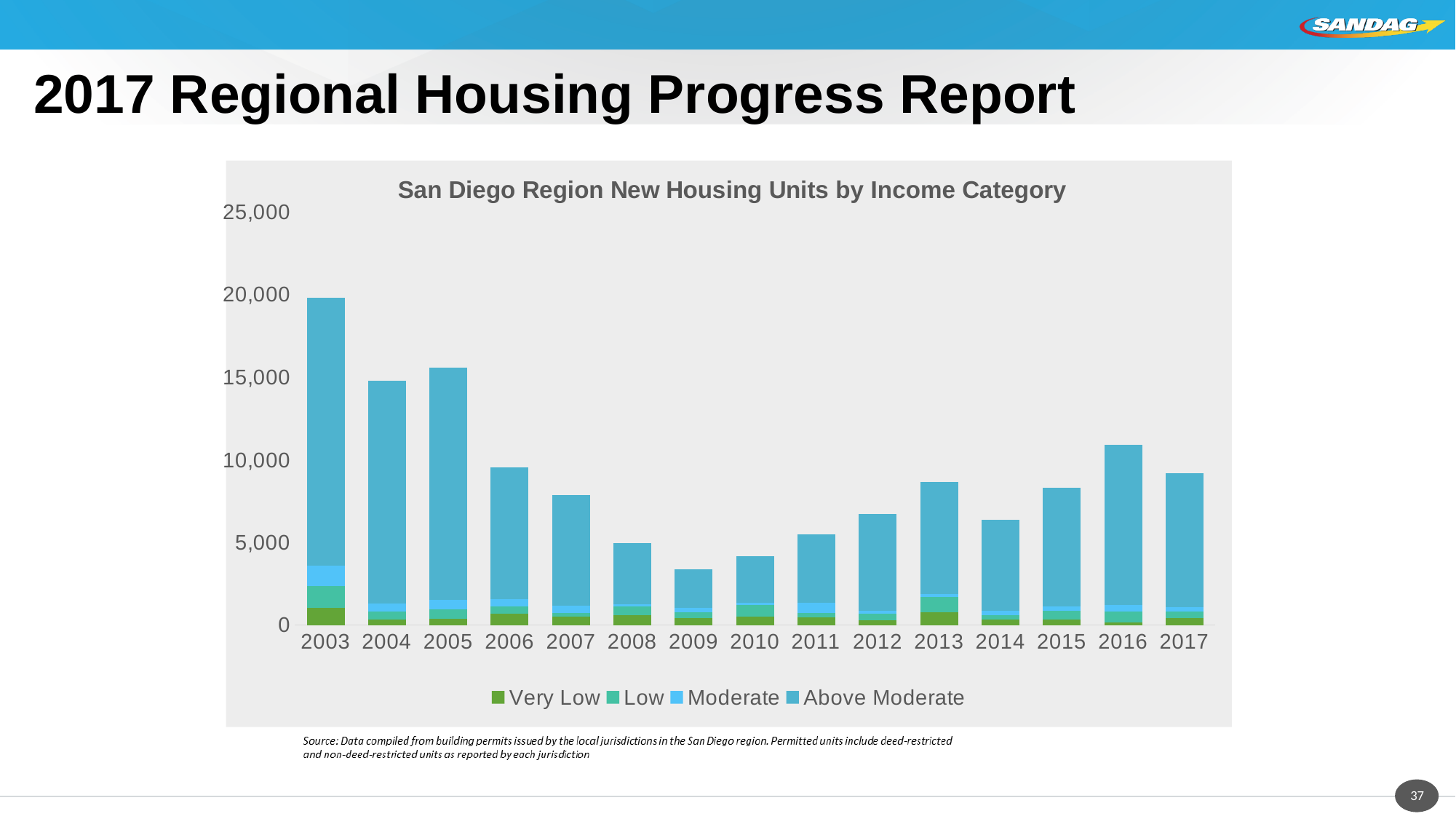
What is the title of the chart? San Diego Region New Housing Units by Income Category Which income category makes up the largest part of each bar? Above Moderate Is the total for 2003 greater or less than 15,000? greater How many years are shown on the x axis? 15 Is the total for 2009 greater or less than 5,000? less Do the total new housing units rise or fall from 2003 to 2009? fall Is the total for 2016 greater or less than 10,000? greater How many series does the legend list? 4 Which year has the lowest total of new housing units? 2009 Which year has a larger total, 2016 or 2017? 2016 Which year has the highest total of new housing units? 2003 What kind of chart is shown on the slide? Stacked bar chart